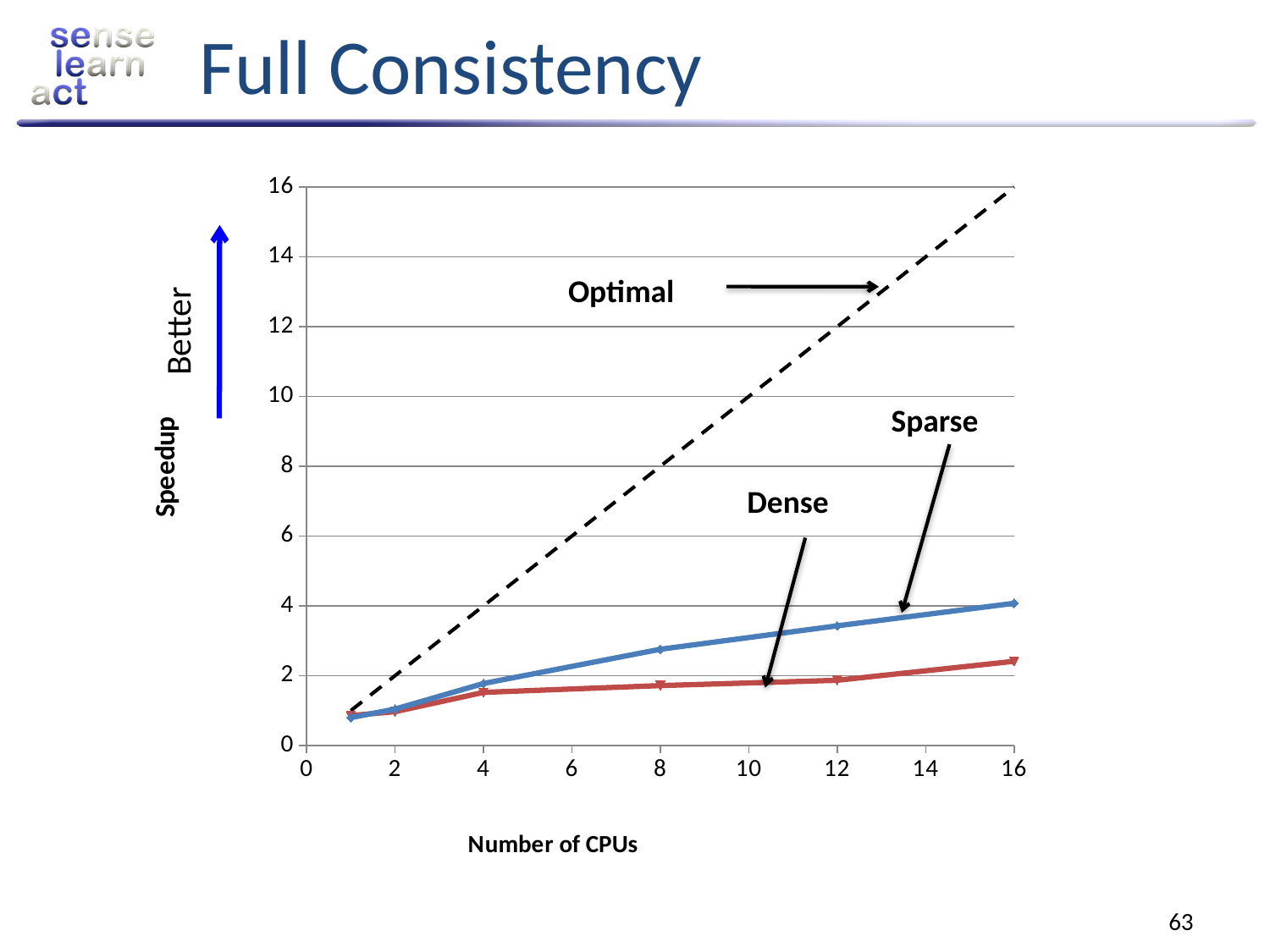
What is the title of the y axis of the chart? Speedup How many lines are plotted on the chart? 3 At 16 CPUs, which has the higher speedup, Sparse or Dense? Sparse Is the Sparse speedup at 16 CPUs greater or less than 2? greater Is the Sparse speedup at 8 CPUs greater or less than 4? less What kind of chart is shown on the slide? line chart What is the title of the x axis of the chart? Number of CPUs Which line is highest at 16 CPUs? Optimal At 12 CPUs, which has the higher speedup, Sparse or Dense? Sparse Which line is lowest at 16 CPUs? Dense Is the Dense speedup at 16 CPUs greater or less than 4? less Does the Sparse speedup rise or fall as the number of CPUs increases? rise